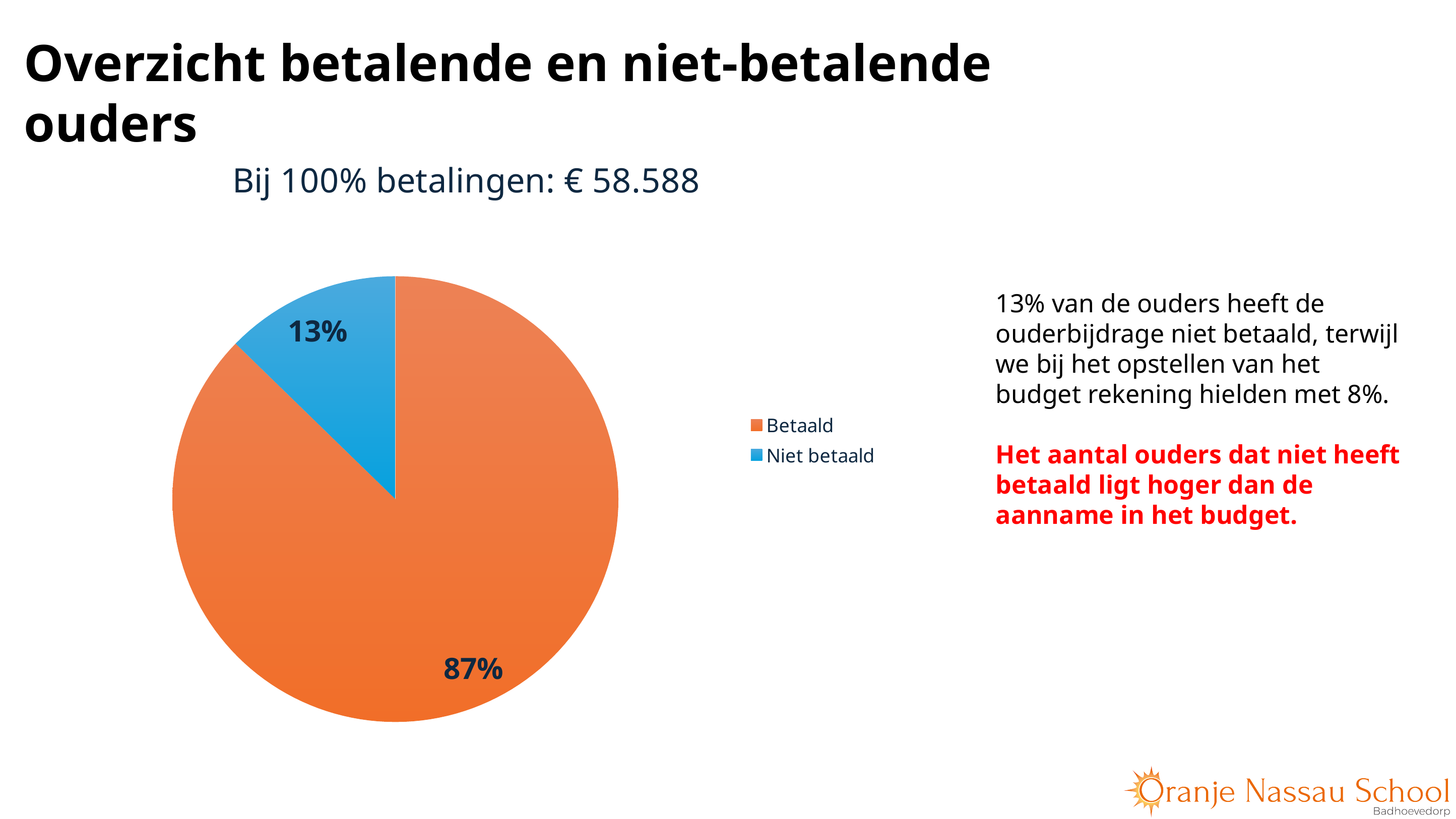
Which slice of the pie is the smallest? Niet betaald What colour is the Betaald slice? orange What kind of chart is shown on the slide? pie chart How many entries does the legend list? 2 What is the difference in percentage points between the Betaald and Niet betaald slices? 74 What colour is the Niet betaald slice? blue What share of the pie does the Niet betaald slice represent? 13% Which is larger, the Betaald slice or the Niet betaald slice? Betaald How many slices does the pie chart have? 2 Which slice of the pie is the largest? Betaald What is the total of the two slice percentages shown on the pie chart? 100% What share of the pie does the Betaald slice represent? 87%